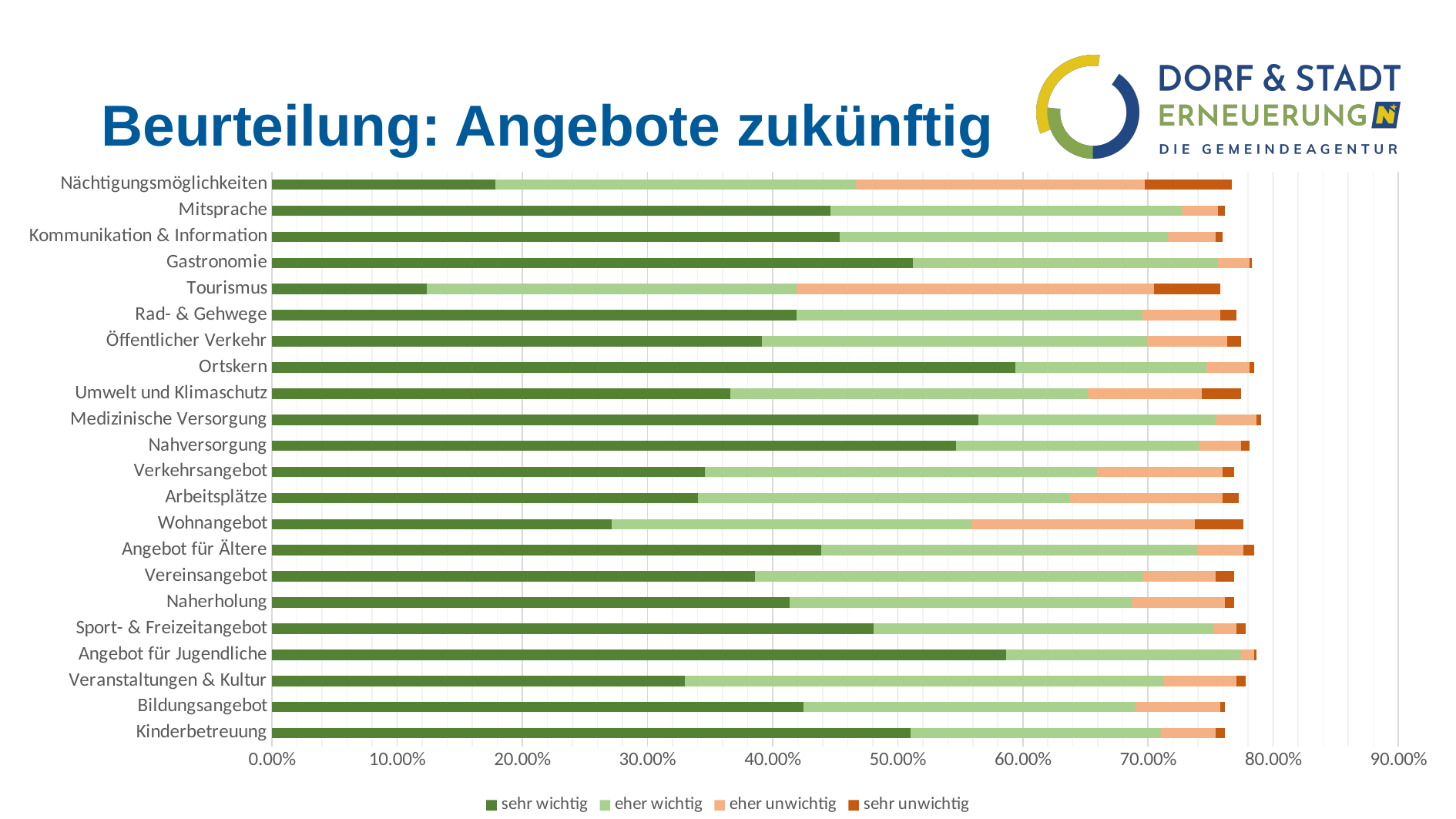
Which category has the smallest 'sehr wichtig' segment? Tourismus What is the title of the chart? Beurteilung: Angebote zukünftig Which has the larger 'sehr wichtig' segment, Ortskern or Tourismus? Ortskern Is the 'sehr wichtig' value for Ortskern greater or less than 50.00%? greater Is the 'sehr wichtig' value for Tourismus greater or less than 20.00%? less How many categories are plotted on the chart? 22 What kind of chart is shown on the slide? Stacked bar chart How many series does the legend list? 4 Which series is listed first in the legend? sehr wichtig Which has the larger 'sehr wichtig' segment, Mitsprache or Wohnangebot? Mitsprache Is the 'sehr wichtig' value for Medizinische Versorgung greater or less than 50.00%? greater